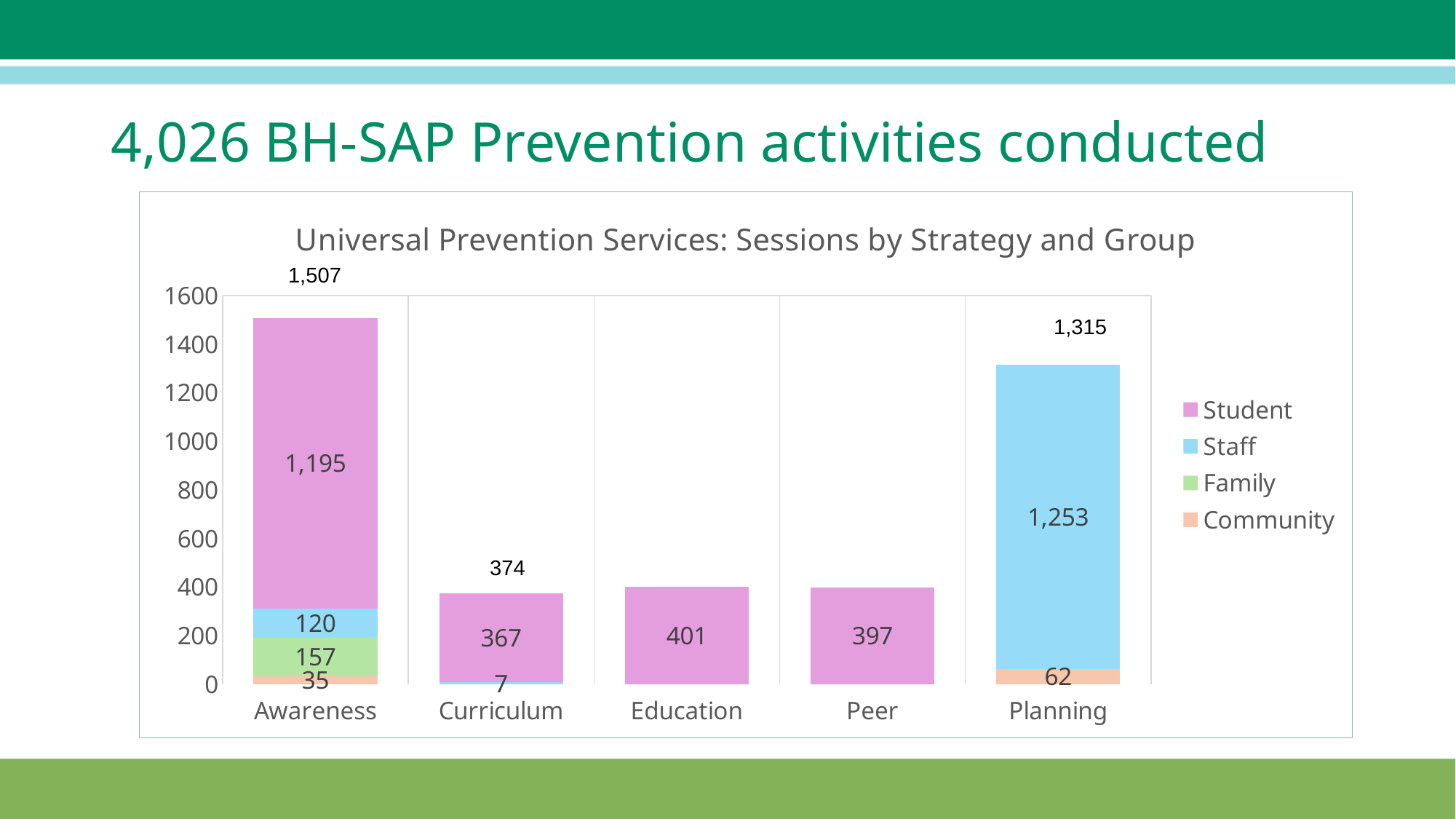
Within the Awareness bar, which is larger: the Staff segment or the Family segment? Family How many Staff sessions are shown for Planning? 1,253 What is the total number of sessions for the Awareness bar? 1,507 How many Student sessions are shown for Awareness? 1,195 How many strategy categories are shown on the x axis? 5 How many Community sessions are shown for Planning? 62 What is the difference between the Student sessions for Education and for Peer? 4 What is the total number of sessions for the Planning bar? 1,315 What kind of chart is shown on the slide? Stacked bar chart Which strategy has the lowest total number of sessions? Curriculum How many series does the legend list? 4 Which strategy has the highest total number of sessions? Awareness